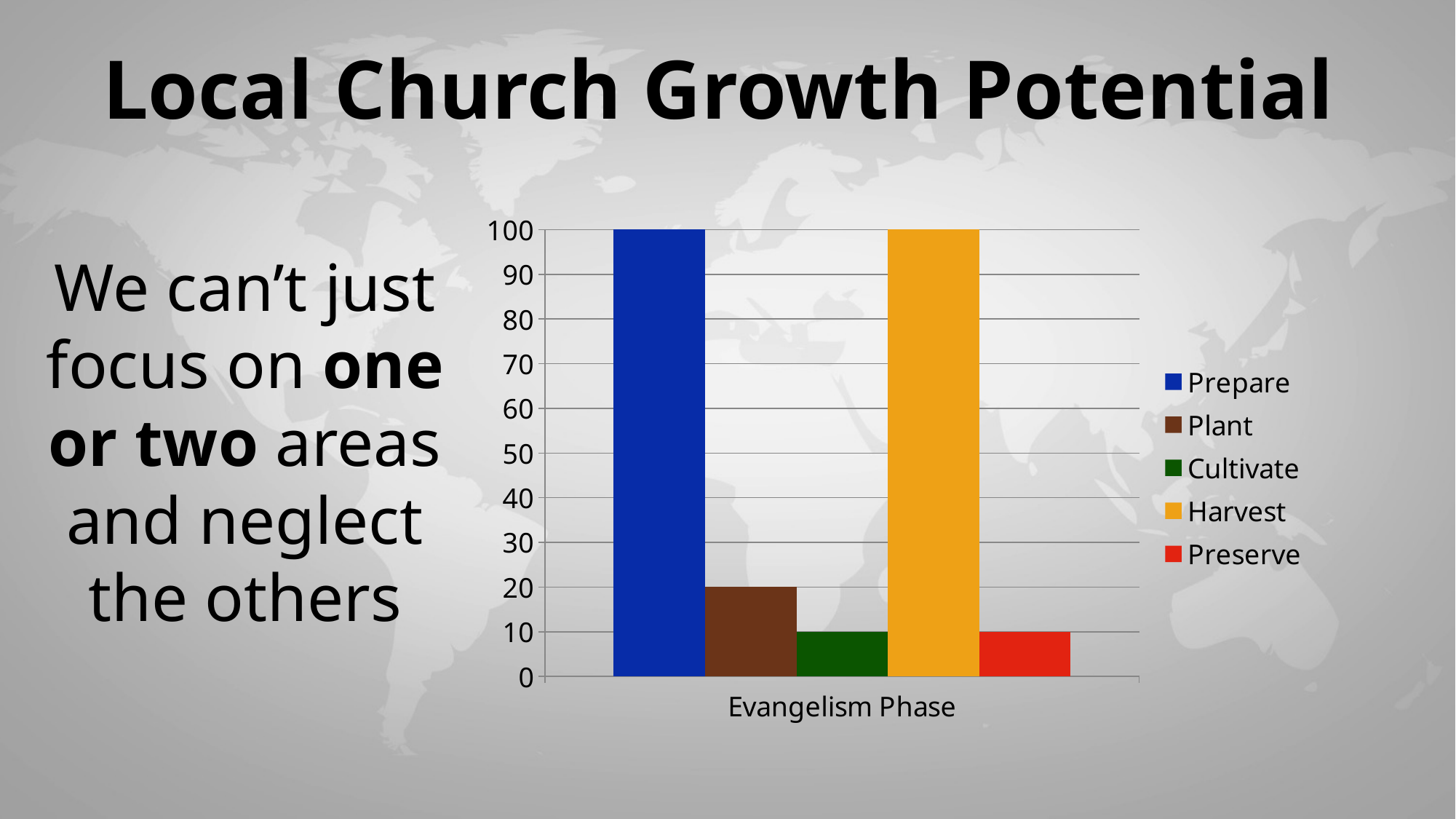
What is the value of the Plant series in the chart? 20 How many series does the legend list? 5 What is the value of the Preserve series in the chart? 10 What is the difference between the Plant value and the Cultivate value? 10 Is the value for Plant greater or less than 50? less What is the value of the Prepare series in the chart? 100 What is the difference between the Prepare value and the Plant value? 80 What is the value of the Harvest series in the chart? 100 What kind of chart is shown on the slide? bar chart What is the label on the x axis of the chart? Evangelism Phase What is the value of the Cultivate series in the chart? 10 Which is larger, the Harvest value or the Preserve value? Harvest